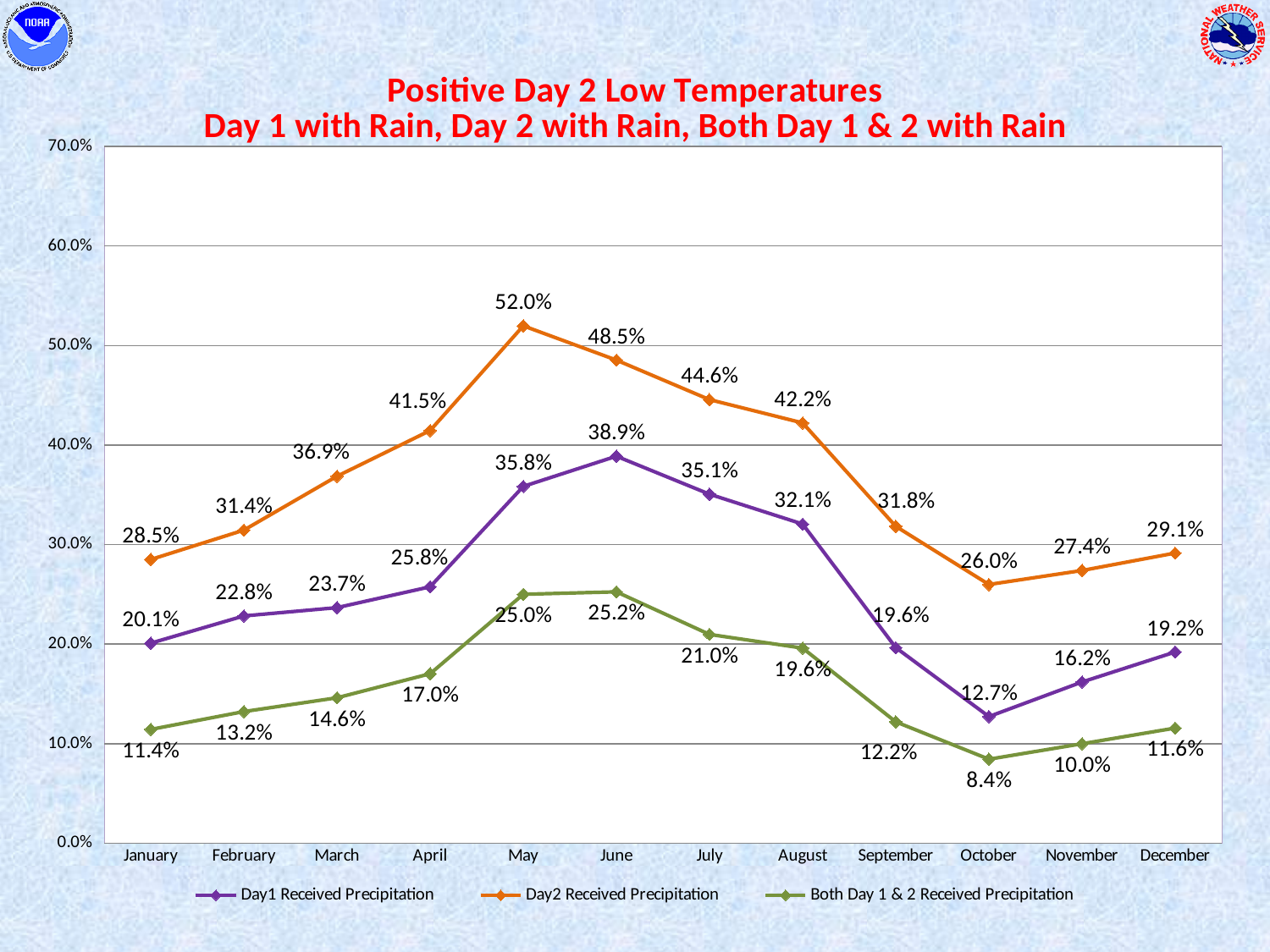
Does Day2 Received Precipitation rise or fall from May to October? fall What is the difference between Day2 Received Precipitation and Day1 Received Precipitation in January? 8.4% How many series does the legend list? 3 Which is larger: Day1 Received Precipitation in June or Day2 Received Precipitation in December? Day1 Received Precipitation in June What is the value for Both Day 1 & 2 Received Precipitation in April? 17.0% In which month is Day1 Received Precipitation highest? June What is the value for Day2 Received Precipitation in May? 52.0% How many months are shown on the x axis? 12 In which month is Both Day 1 & 2 Received Precipitation lowest? October Is the value for Day2 Received Precipitation in August greater or less than 40.0%? greater What is the value for Day1 Received Precipitation in October? 12.7% What kind of chart is shown on the slide? line chart